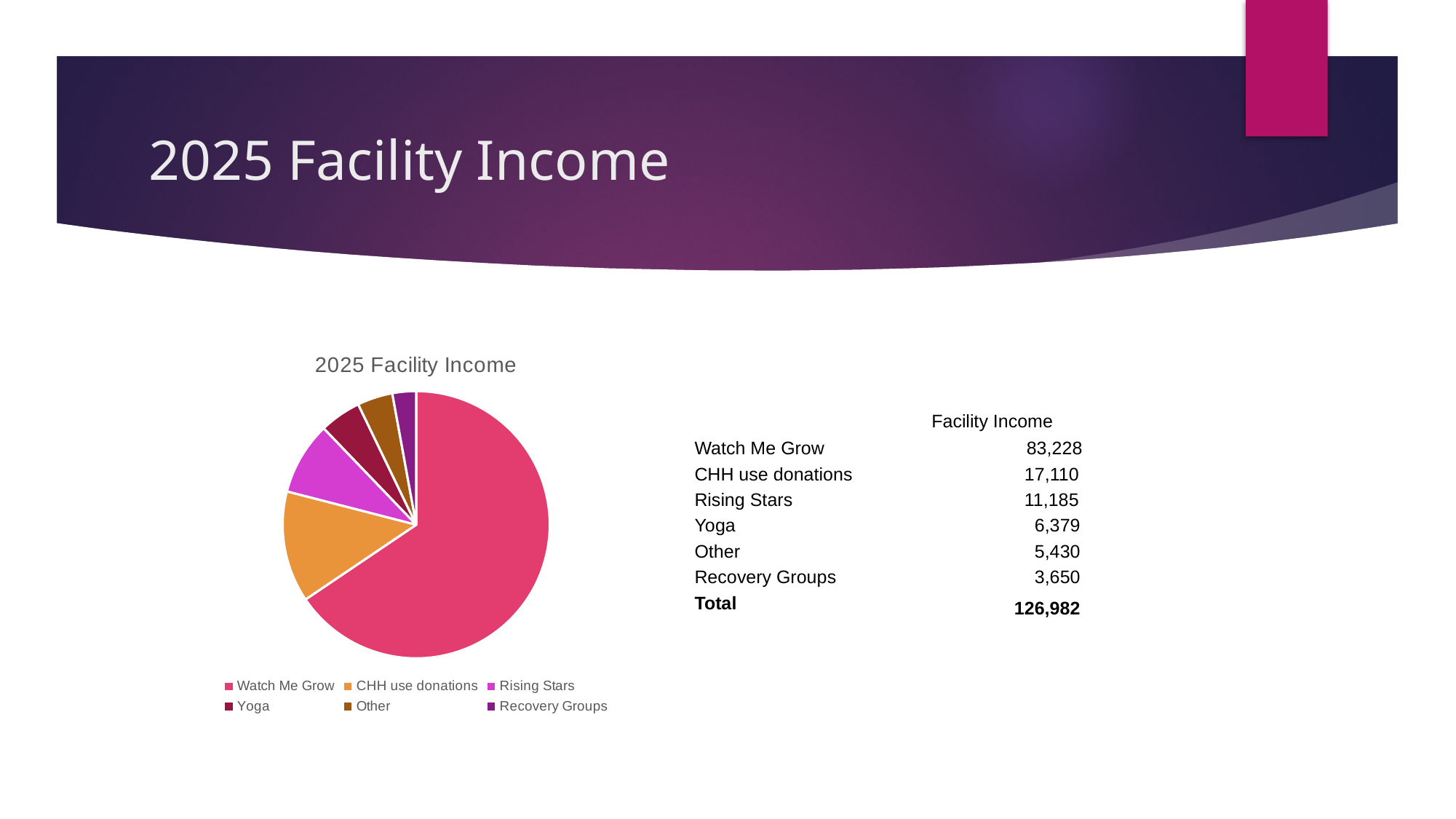
Which category has the smallest share of the pie? Recovery Groups How many categories does the pie chart have? 6 What is the title of the chart? 2025 Facility Income Which colour represents CHH use donations in the pie chart? Orange Which is larger, the income from Rising Stars or from Yoga? Rising Stars What type of chart is shown on the slide? Pie chart What is the difference between the income from Watch Me Grow and from CHH use donations? 66,118 What is the total facility income across all categories? 126,982 What is the facility income for Recovery Groups? 3,650 Which category has the largest share of the pie? Watch Me Grow What is the facility income for CHH use donations? 17,110 What is the facility income for Watch Me Grow? 83,228